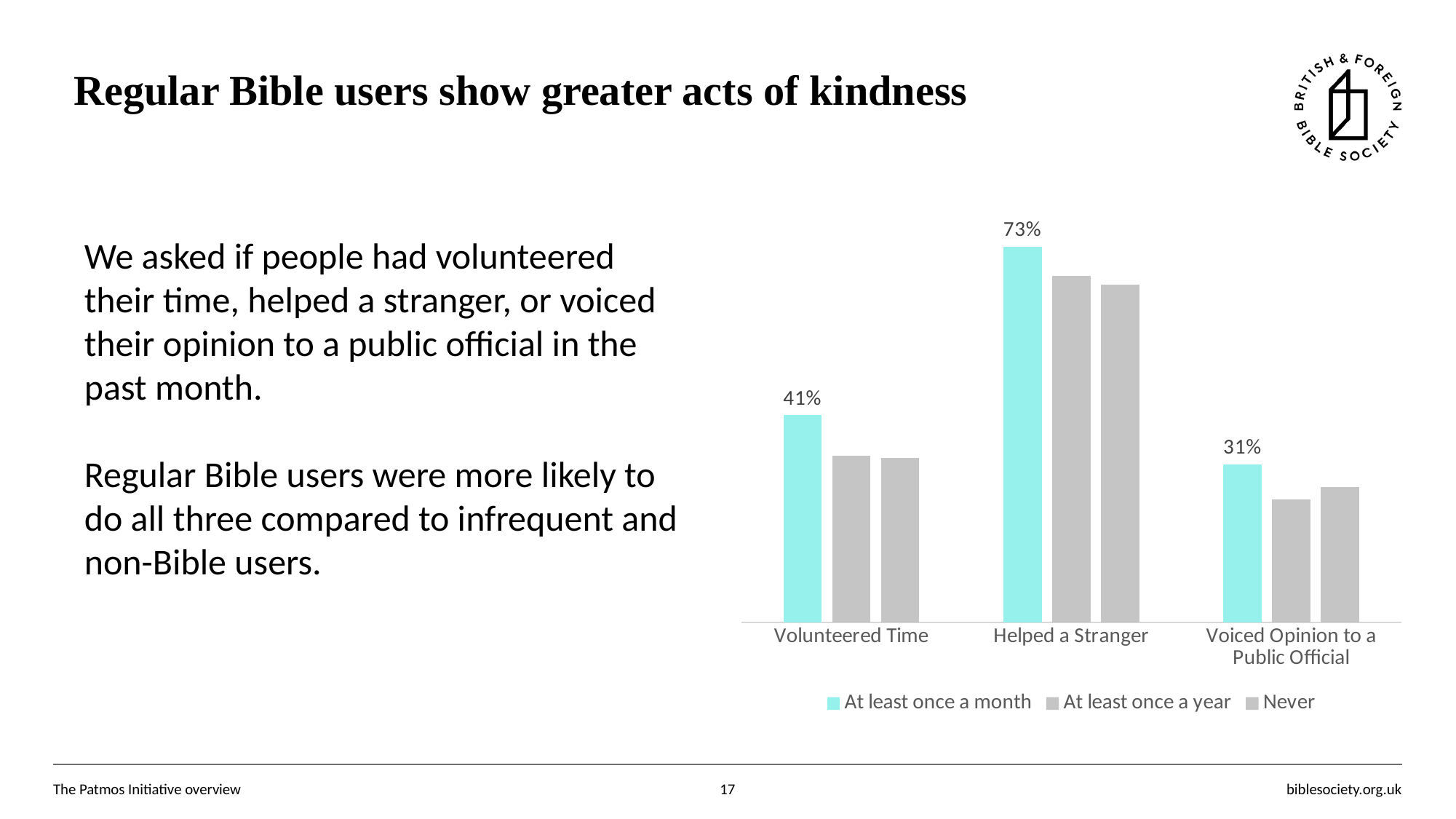
In the Helped a Stranger category, which is larger: 'At least once a month' or 'At least once a year'? At least once a month Which category has the highest value for the 'At least once a month' series? Helped a Stranger What kind of chart is shown on the slide? Bar chart In the Volunteered Time category, which is larger: 'At least once a month' or 'Never'? At least once a month What is the value for 'At least once a month' in the Helped a Stranger category? 73% How many categories are shown on the x axis of the chart? 3 Which category has the lowest value for the 'At least once a month' series? Voiced Opinion to a Public Official What is the difference between the 'At least once a month' values for Volunteered Time and Voiced Opinion to a Public Official? 10% What is the difference between the 'At least once a month' values for Helped a Stranger and Volunteered Time? 32% How many series does the chart legend list? 3 What is the value for 'At least once a month' in the Volunteered Time category? 41% What is the value for 'At least once a month' in the Voiced Opinion to a Public Official category? 31%